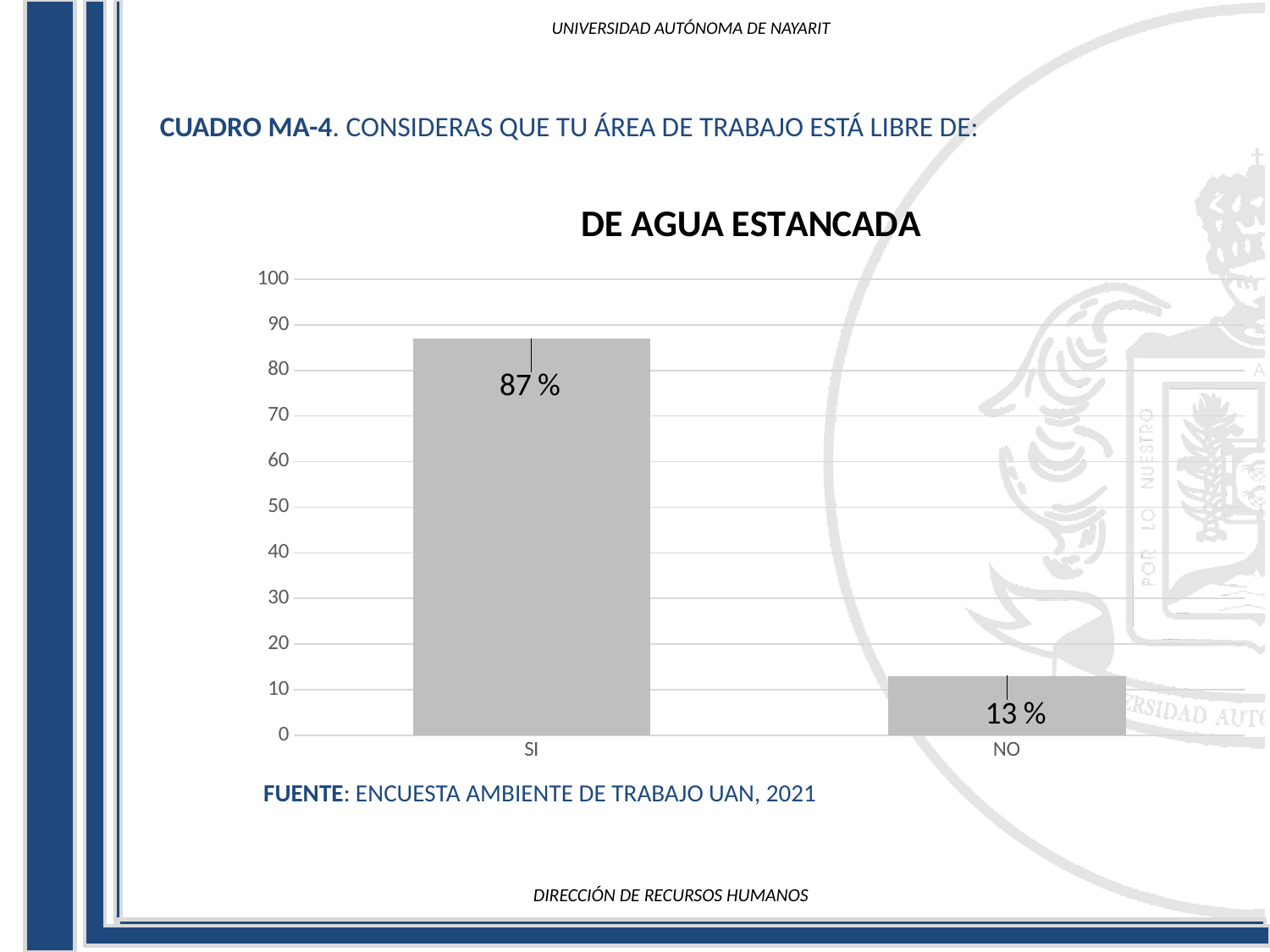
Is the value for NO greater or less than 20? less What is the value for SI? 87 % What is the value for NO? 13 % How many categories are shown on the x axis? 2 What is the title of the chart? DE AGUA ESTANCADA Which category has the highest value? SI What is the difference between the values for SI and NO? 74 % Which is larger, the value for SI or the value for NO? SI What is the highest value shown on the y axis? 100 What kind of chart is shown? bar chart Is the value for SI greater or less than 80? greater Which category has the lowest value? NO